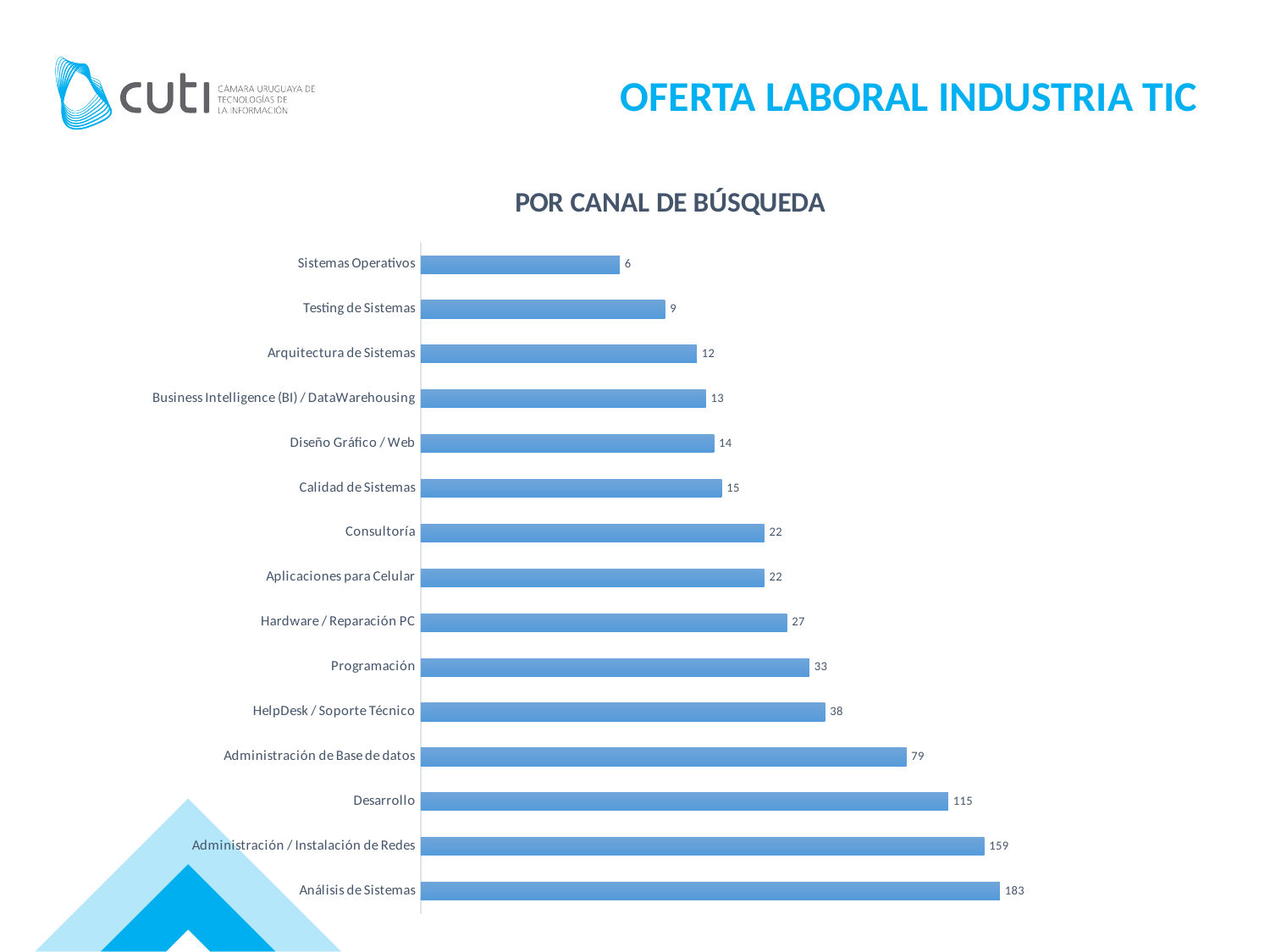
Which category has the highest value? Análisis de Sistemas What is the value for Diseño Gráfico / Web? 14 What is the value for Administración de Base de datos? 79 What is the value for Desarrollo? 115 Which is larger, Hardware / Reparación PC or Consultoría? Hardware / Reparación PC What kind of chart is shown on the slide? Bar chart What is the value for Testing de Sistemas? 9 How many categories are shown in the chart? 15 What is the difference between Programación and HelpDesk / Soporte Técnico? 5 Which category has the lowest value? Sistemas Operativos What is the title of the chart? POR CANAL DE BÚSQUEDA What is the difference between Análisis de Sistemas and Administración / Instalación de Redes? 24